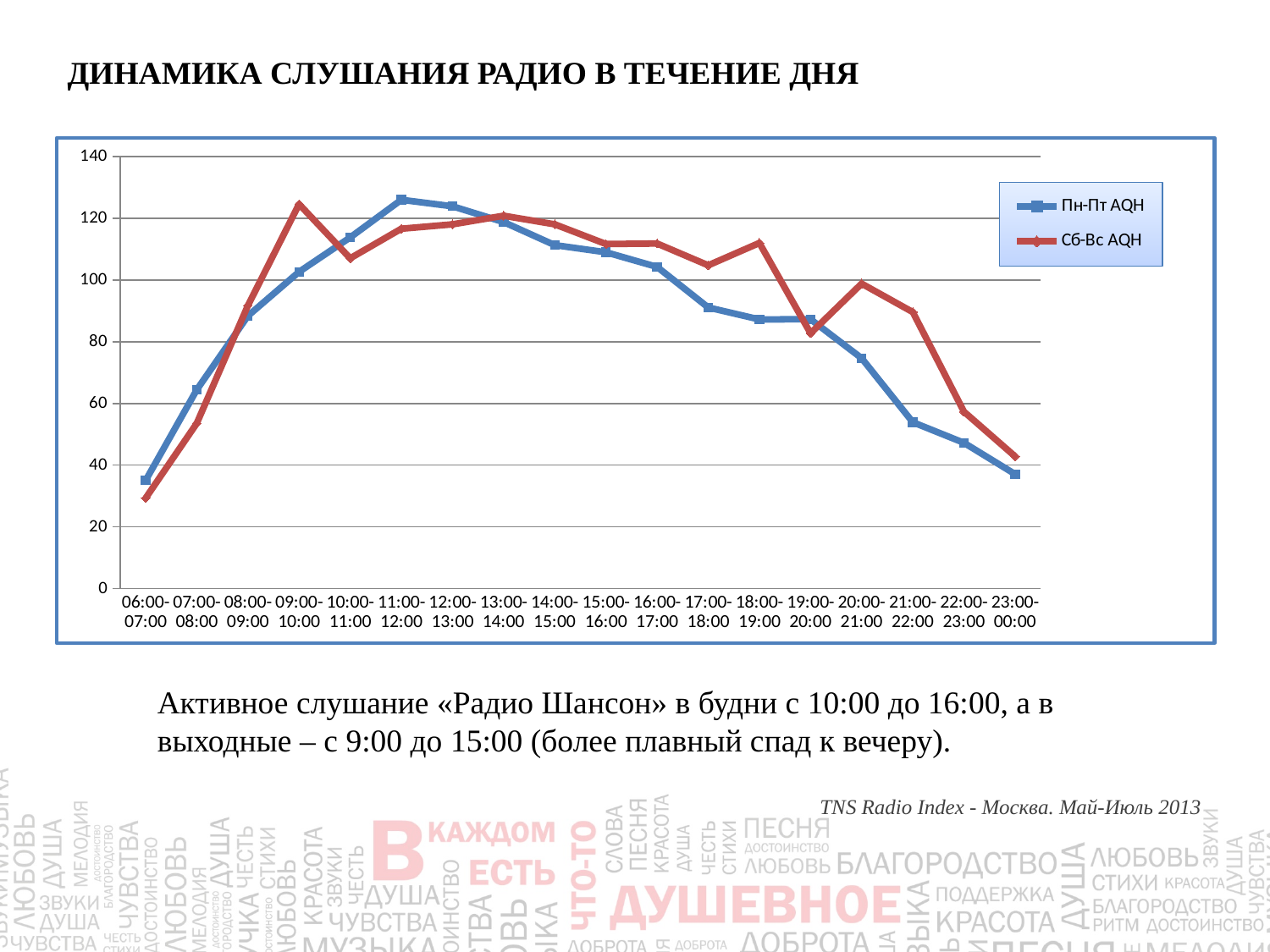
Which series is drawn in red? Сб-Вс AQH What is the title of the slide's chart section? ДИНАМИКА СЛУШАНИЯ РАДИО В ТЕЧЕНИЕ ДНЯ How many series does the legend list? 2 Does the Пн-Пт AQH series rise or fall from 16:00-17:00 to 23:00-00:00? fall In which time slot does the Пн-Пт AQH series reach its highest value? 11:00-12:00 In which time slot does the Сб-Вс AQH series reach its lowest value? 06:00-07:00 At 09:00-10:00, which series has the larger value, Пн-Пт AQH or Сб-Вс AQH? Сб-Вс AQH Is the value for Пн-Пт AQH at 11:00-12:00 greater or less than 120? greater Is the value for Пн-Пт AQH at 21:00-22:00 greater or less than 60? less How many time slots are shown on the x axis? 18 What kind of chart is shown on the slide? line chart Is the value for Сб-Вс AQH at 06:00-07:00 greater or less than 40? less